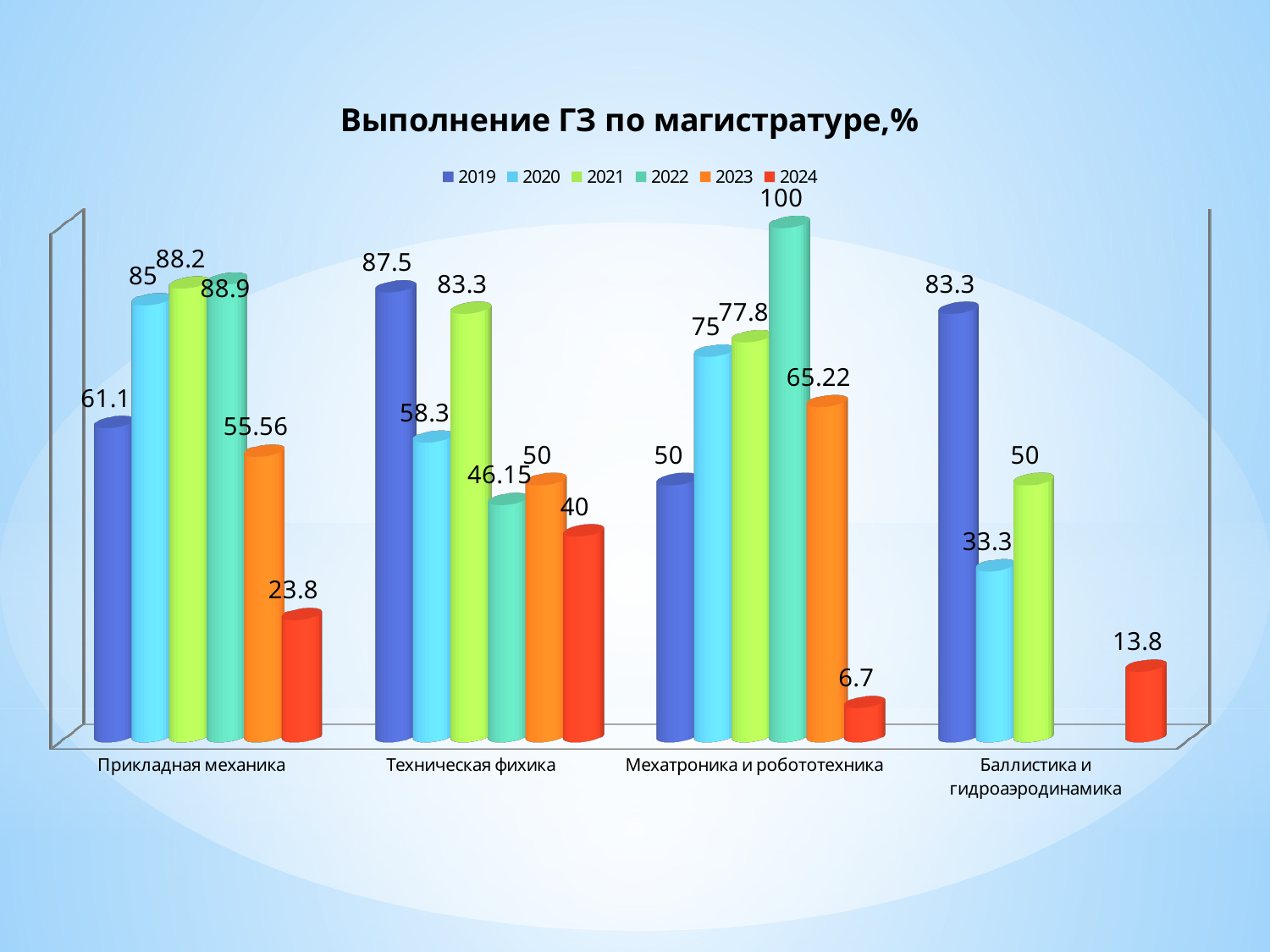
What is the value for 2024 in the Прикладная механика category? 23.8 What kind of chart is shown on the slide? Bar chart What is the difference between the 2021 and 2020 values for Баллистика и гидроаэродинамика? 16.7 Which category has the highest value for the 2019 series? Техническая фихика What is the difference between the 2019 and 2024 values for Техническая фихика? 47.5 Which is larger: the 2020 value for Прикладная механика or the 2020 value for Мехатроника и робототехника? Прикладная механика How many series does the legend list? 6 What is the title of the chart? Выполнение ГЗ по магистратуре,% What is the value for 2023 in the Мехатроника и робототехника category? 65.22 Which category has the lowest value for the 2024 series? Мехатроника и робототехника How many categories are shown on the x axis? 4 What is the value for 2022 in the Мехатроника и робототехника category? 100